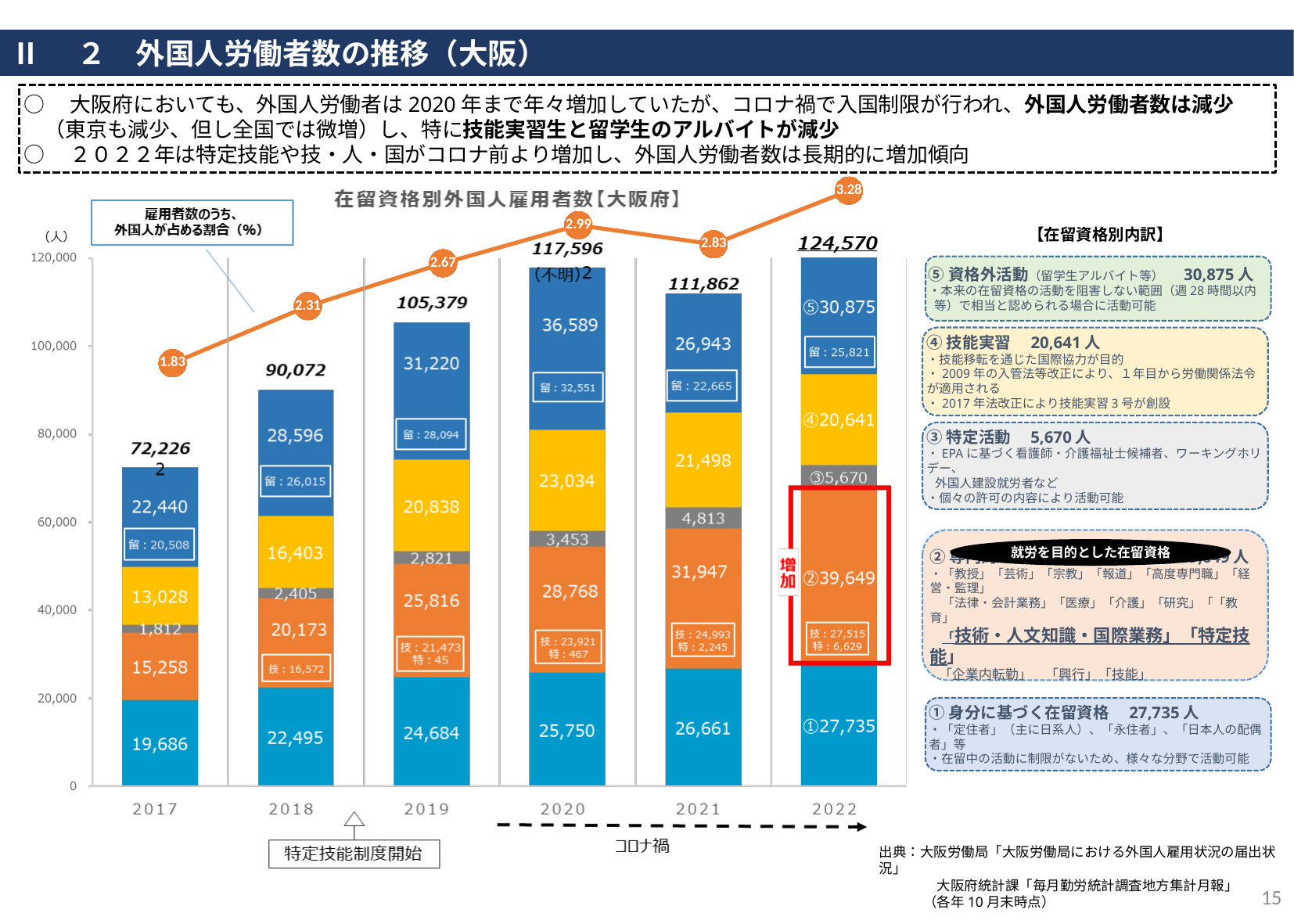
What is the value of the line (雇用者数のうち、外国人が占める割合) for 2022? 3.28 What is the value of the bottom (身分に基づく在留資格) segment for 2021? 26,661 What is the difference between the total for 2020 and the total for 2021? 5,734 What is the value of the line (雇用者数のうち、外国人が占める割合) for 2020? 2.99 How many years are shown on the x axis of the chart? 6 What is the total number of foreign workers in Osaka shown for 2022 in the chart 在留資格別外国人雇用者数【大阪府】? 124,570 What is the value of the 技能実習 (yellow) segment for 2019? 20,838 What kind of chart is used to show the foreign worker numbers by residence status? Stacked bar chart with a line overlay Which year has the lowest total number of foreign workers in the chart? 2017 What is the total number of foreign workers shown for 2017? 72,226 Which year has the highest total number of foreign workers in the chart? 2022 Is the 資格外活動 (dark blue) segment larger in 2020 or in 2021? 2020